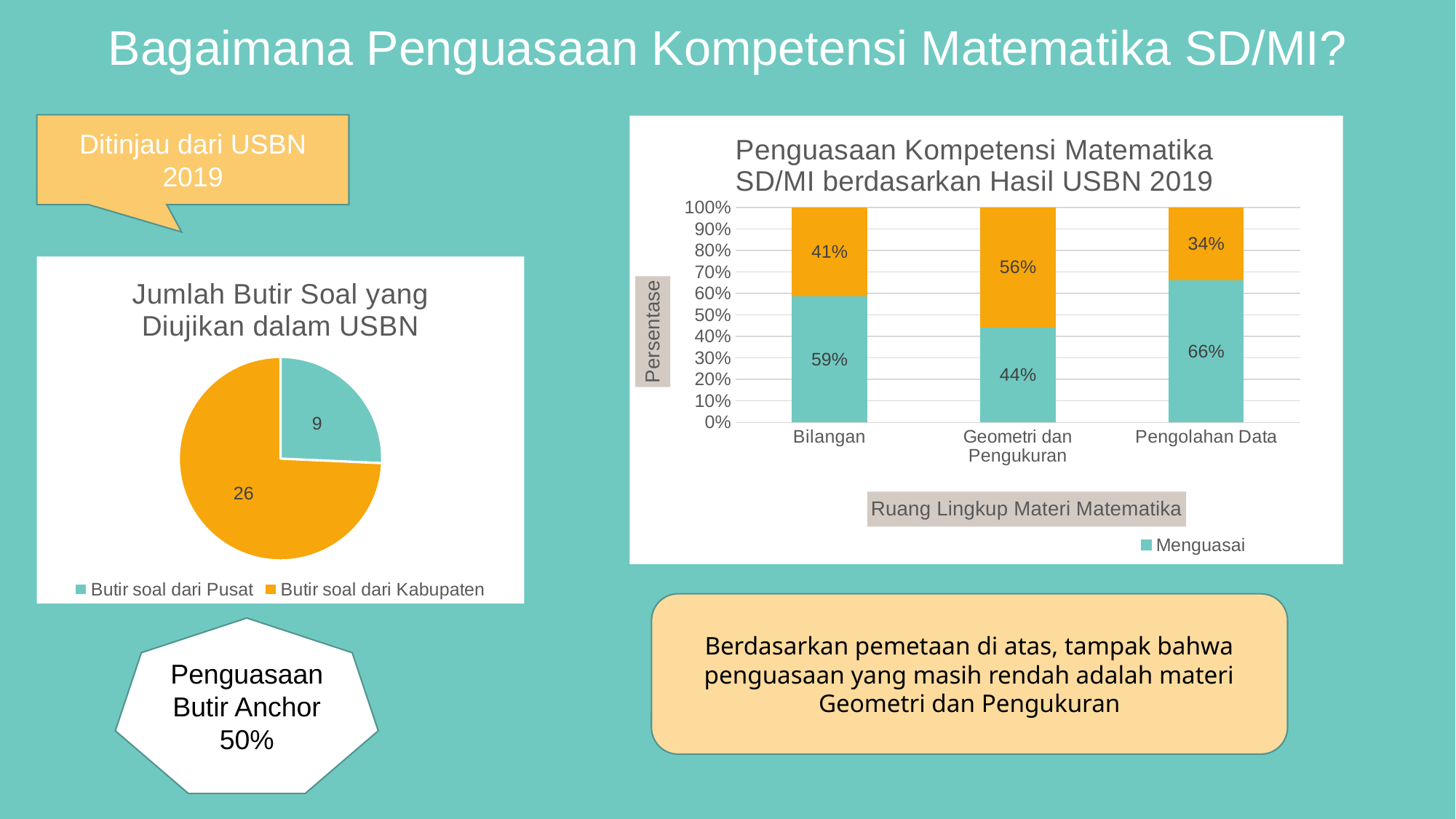
In the chart 'Penguasaan Kompetensi Matematika SD/MI berdasarkan Hasil USBN 2019', which category has the lowest Menguasai value? Geometri dan Pengukuran In the chart 'Penguasaan Kompetensi Matematika SD/MI berdasarkan Hasil USBN 2019', what is the difference between the Menguasai values for Pengolahan Data and Bilangan? 7% In the pie chart 'Jumlah Butir Soal yang Diujikan dalam USBN', what is the total number of items across both slices? 35 In the chart 'Penguasaan Kompetensi Matematika SD/MI berdasarkan Hasil USBN 2019', what is the Menguasai value for Geometri dan Pengukuran? 44% In the chart 'Penguasaan Kompetensi Matematika SD/MI berdasarkan Hasil USBN 2019', what is the value of the orange segment for Bilangan? 41% In the pie chart 'Jumlah Butir Soal yang Diujikan dalam USBN', what is the value for Butir soal dari Kabupaten? 26 In the pie chart 'Jumlah Butir Soal yang Diujikan dalam USBN', what is the value for Butir soal dari Pusat? 9 In the pie chart 'Jumlah Butir Soal yang Diujikan dalam USBN', what is the difference between Butir soal dari Kabupaten and Butir soal dari Pusat? 17 What type of chart is 'Jumlah Butir Soal yang Diujikan dalam USBN'? pie chart In the pie chart 'Jumlah Butir Soal yang Diujikan dalam USBN', which category has the larger slice? Butir soal dari Kabupaten How many categories are shown on the x axis of the chart 'Penguasaan Kompetensi Matematika SD/MI berdasarkan Hasil USBN 2019'? 3 In the chart 'Penguasaan Kompetensi Matematika SD/MI berdasarkan Hasil USBN 2019', what is the Menguasai value for Pengolahan Data? 66%